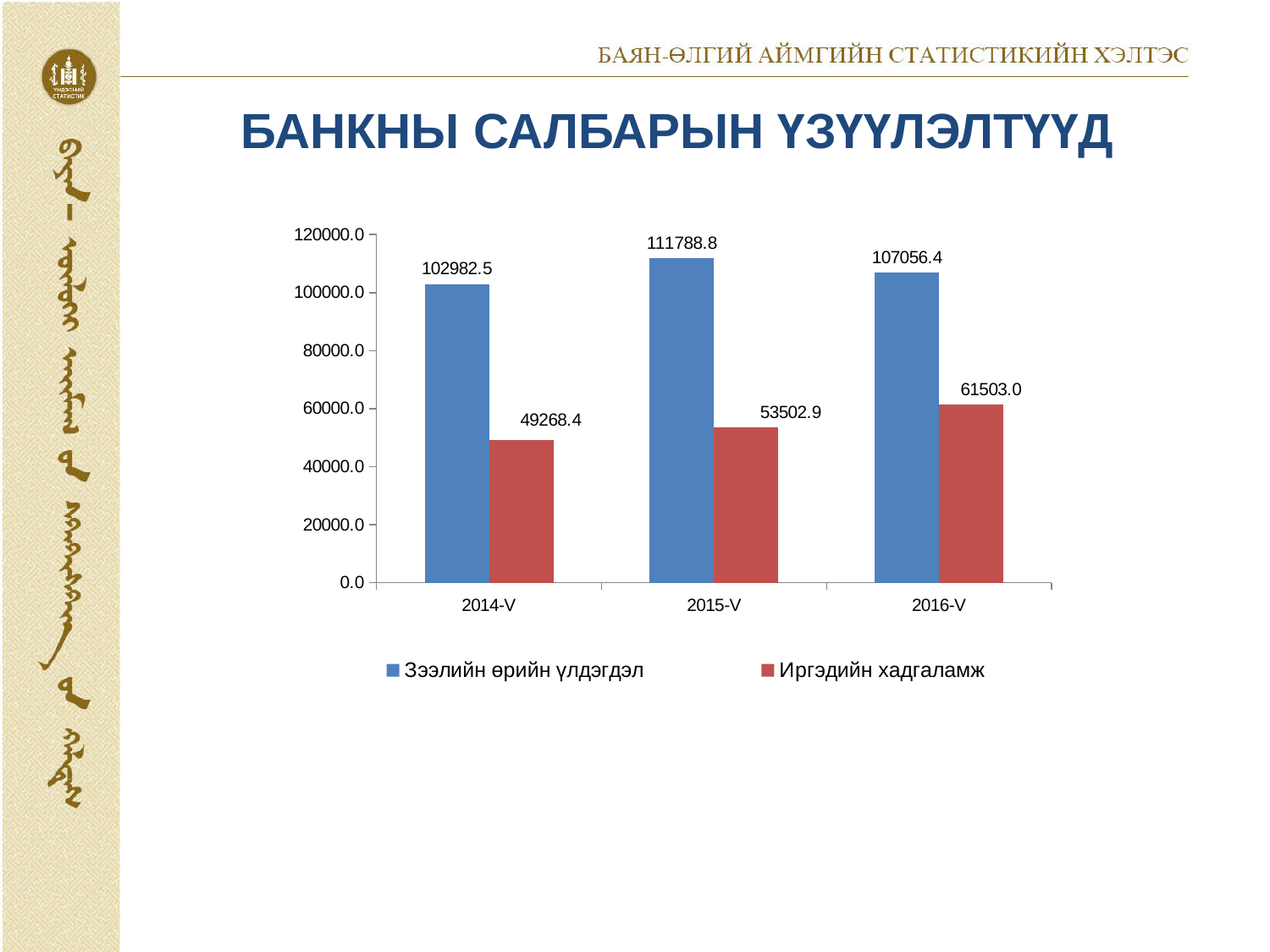
What is the value of Иргэдийн хадгаламж for 2015-V? 53502.9 How many periods are shown on the x axis? 3 What is the value of Зээлийн өрийн үлдэгдэл for 2014-V? 102982.5 In which period is Зээлийн өрийн үлдэгдэл highest? 2015-V In which period is Иргэдийн хадгаламж lowest? 2014-V Is the value of Иргэдийн хадгаламж for 2016-V greater or less than 60000.0? greater Does Иргэдийн хадгаламж rise or fall from 2014-V to 2016-V? rise What is the difference between Зээлийн өрийн үлдэгдэл in 2015-V and in 2014-V? 8806.3 What is the value of Иргэдийн хадгаламж for 2016-V? 61503.0 How many series does the legend list? 2 Which is larger in 2016-V: Зээлийн өрийн үлдэгдэл or Иргэдийн хадгаламж? Зээлийн өрийн үлдэгдэл What is the difference between Иргэдийн хадгаламж in 2016-V and in 2014-V? 12234.6